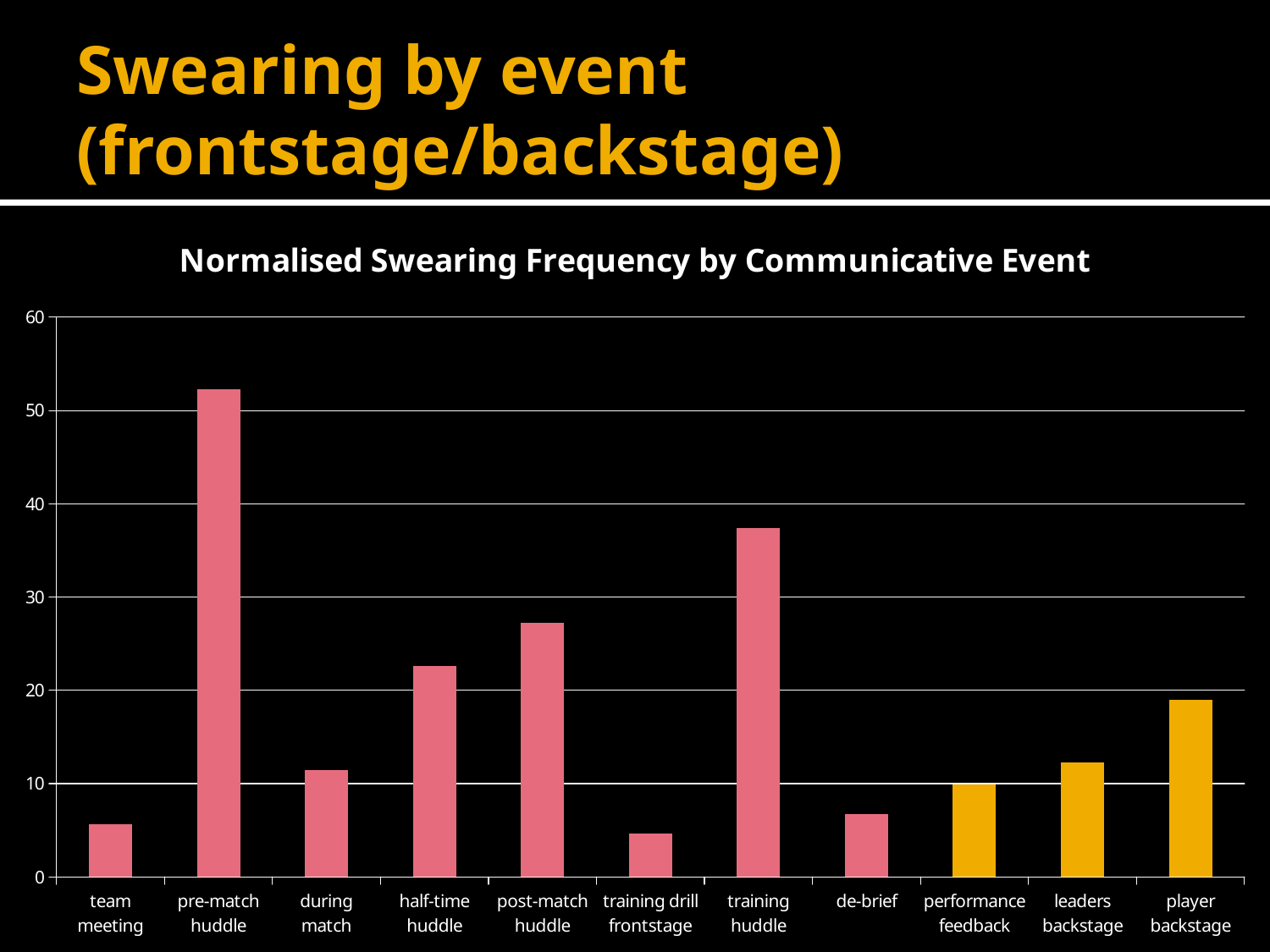
Is the value for training huddle greater or less than 30? greater Is the value for team meeting greater or less than 10? less Which is larger, the value for player backstage or the value for leaders backstage? player backstage Which communicative event has the highest normalised swearing frequency? pre-match huddle What type of chart is shown on the slide? bar chart How many bars are coloured orange rather than pink? 3 What is the title of the chart? Normalised Swearing Frequency by Communicative Event Is the value for half-time huddle greater or less than 20? greater Which is larger, the value for training huddle or the value for post-match huddle? training huddle How many communicative event categories are shown on the x axis? 11